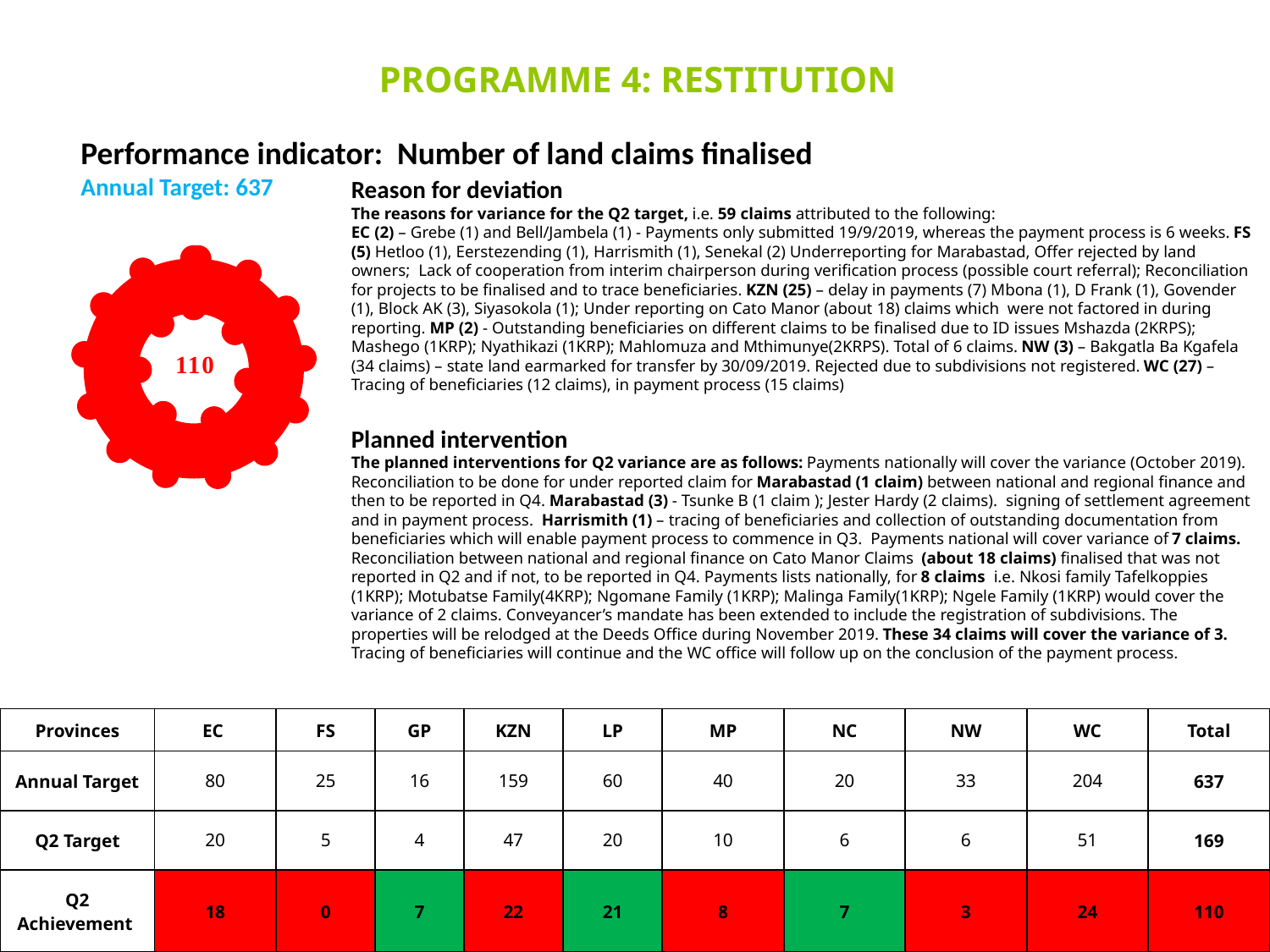
What kind of chart is shown on the left of the slide? doughnut chart What number is printed in the centre of the chart on the left of the slide? 110 Does the chart on the left of the slide have a legend? No What colour is the ring of the chart on the left of the slide? red